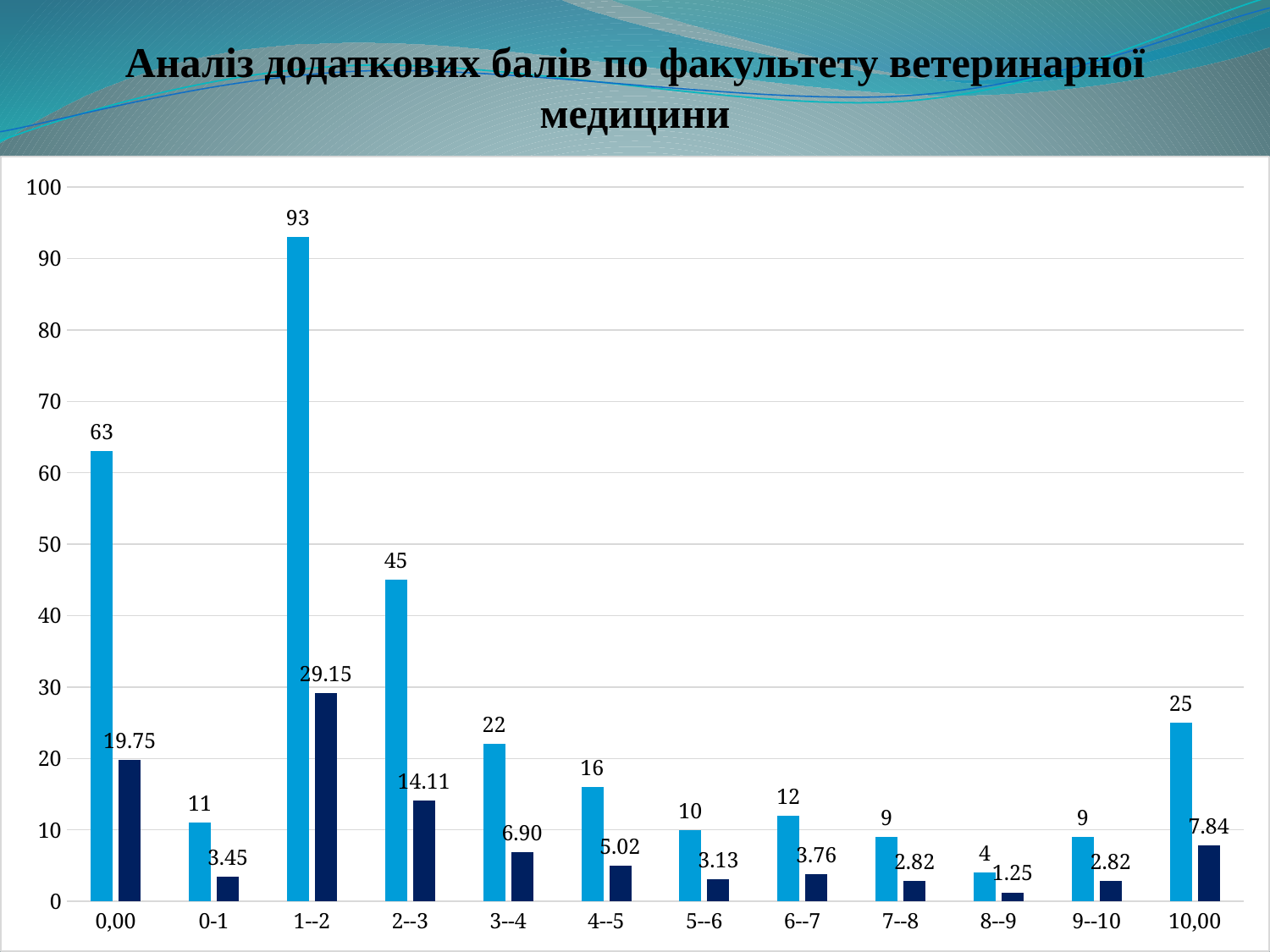
Is the light blue value for 0,00 greater or less than 60? greater What is the difference between the light blue values for 1--2 and 0,00? 30 What is the title of the chart? Аналіз додаткових балів по факультету ветеринарної медицини What is the value of the light blue bar for the category 1--2? 93 Which category has the lowest dark blue bar? 8--9 Which category has the highest light blue bar? 1--2 How many categories are shown on the x axis? 12 Which is larger, the light blue value for 2--3 or the light blue value for 10,00? 2--3 What kind of chart is shown on the slide? bar chart What is the value of the dark blue bar for the category 10,00? 7.84 What is the difference between the dark blue values for 2--3 and 3--4? 7.21 What is the value of the dark blue bar for the category 0,00? 19.75